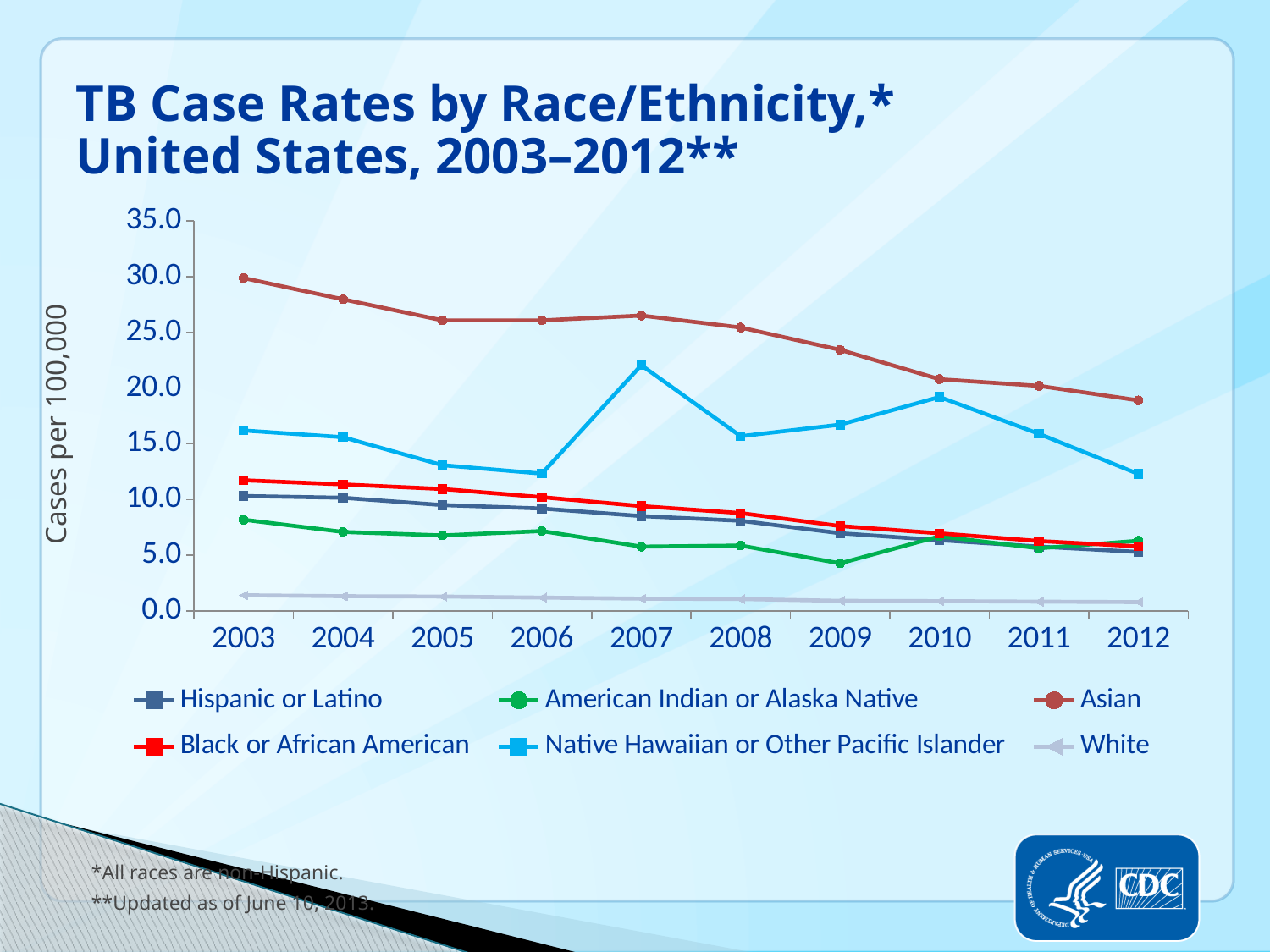
Is the value for Native Hawaiian or Other Pacific Islander in 2007 greater or less than 20.0? greater What is the title of the chart? TB Case Rates by Race/Ethnicity,* United States, 2003–2012** Does the TB case rate for Asian rise or fall from 2003 to 2012? fall In 2012, which is larger: the value for Native Hawaiian or Other Pacific Islander or the value for Hispanic or Latino? Native Hawaiian or Other Pacific Islander What is the label on the y axis? Cases per 100,000 Which race/ethnicity has the lowest TB case rate in 2012? White What kind of chart is shown on the slide? line chart How many series does the legend list? 6 Which race/ethnicity has the highest TB case rate in 2003? Asian How many years are plotted along the x axis? 10 Is the value for White in 2003 greater or less than 5.0? less Is the value for Asian in 2003 greater or less than 25.0? greater